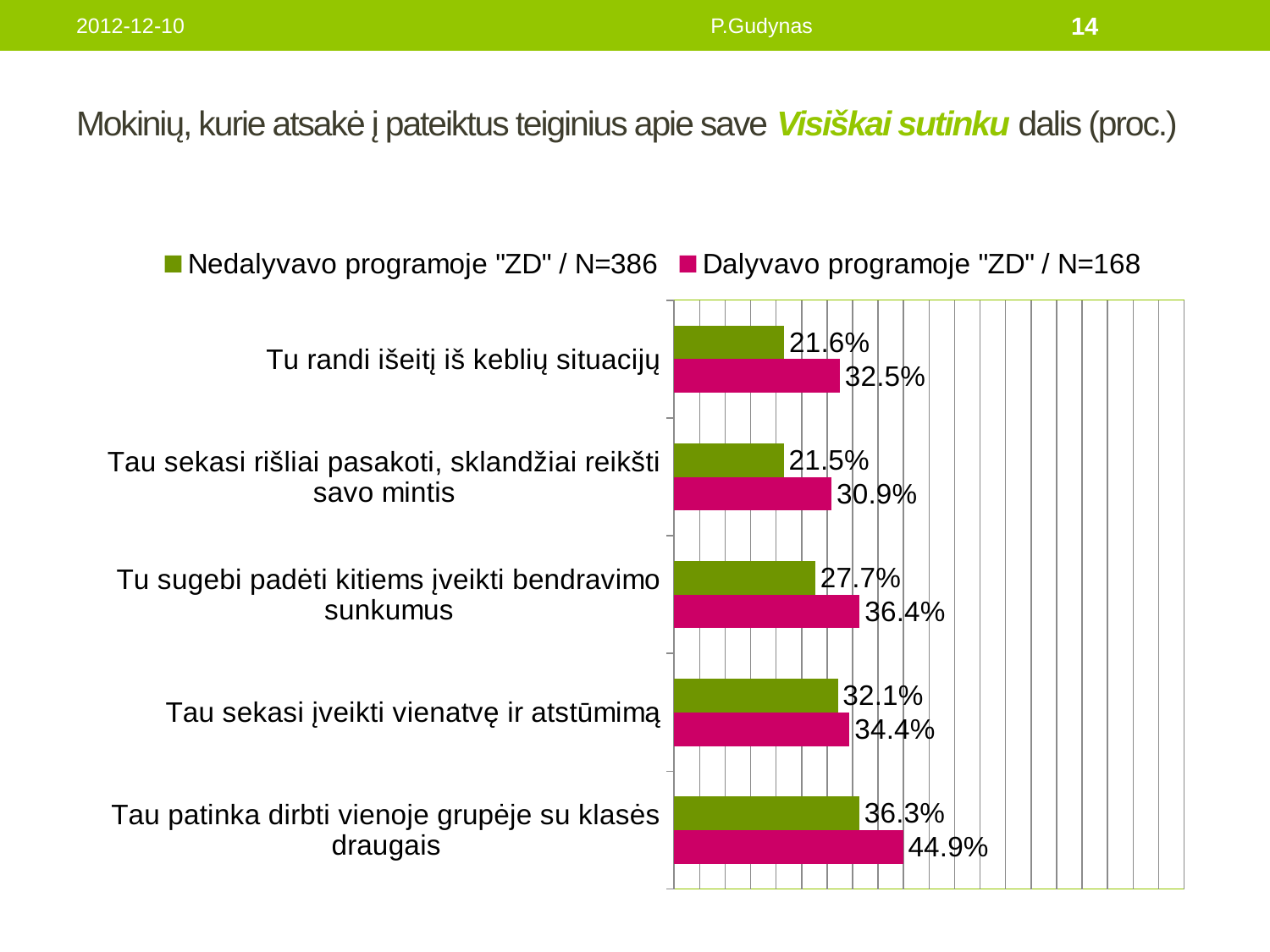
What is the difference between the Dalyvavo and Nedalyvavo values for "Tau patinka dirbti vienoje grupėje su klasės draugais"? 8.6% How many series does the legend list? 2 What is the value for "Tu sugebi padėti kitiems įveikti bendravimo sunkumus" in the Dalyvavo programoje "ZD" / N=168 series? 36.4% What is the difference between the Dalyvavo and Nedalyvavo values for "Tu randi išeitį iš keblių situacijų"? 10.9% What is the value for "Tu randi išeitį iš keblių situacijų" in the Dalyvavo programoje "ZD" / N=168 series? 32.5% Which category has the highest value in the Dalyvavo programoje "ZD" / N=168 series? Tau patinka dirbti vienoje grupėje su klasės draugais For "Tu sugebi padėti kitiems įveikti bendravimo sunkumus", which series has the larger value? Dalyvavo programoje "ZD" / N=168 Which category has the highest value in the Nedalyvavo programoje "ZD" / N=386 series? Tau patinka dirbti vienoje grupėje su klasės draugais Which category has the lowest value in the Dalyvavo programoje "ZD" / N=168 series? Tau sekasi rišliai pasakoti, sklandžiai reikšti savo mintis How many categories are shown in the chart? 5 What is the value for "Tau patinka dirbti vienoje grupėje su klasės draugais" in the Nedalyvavo programoje "ZD" / N=386 series? 36.3% What is the value for "Tau sekasi įveikti vienatvę ir atstūmimą" in the Nedalyvavo programoje "ZD" / N=386 series? 32.1%